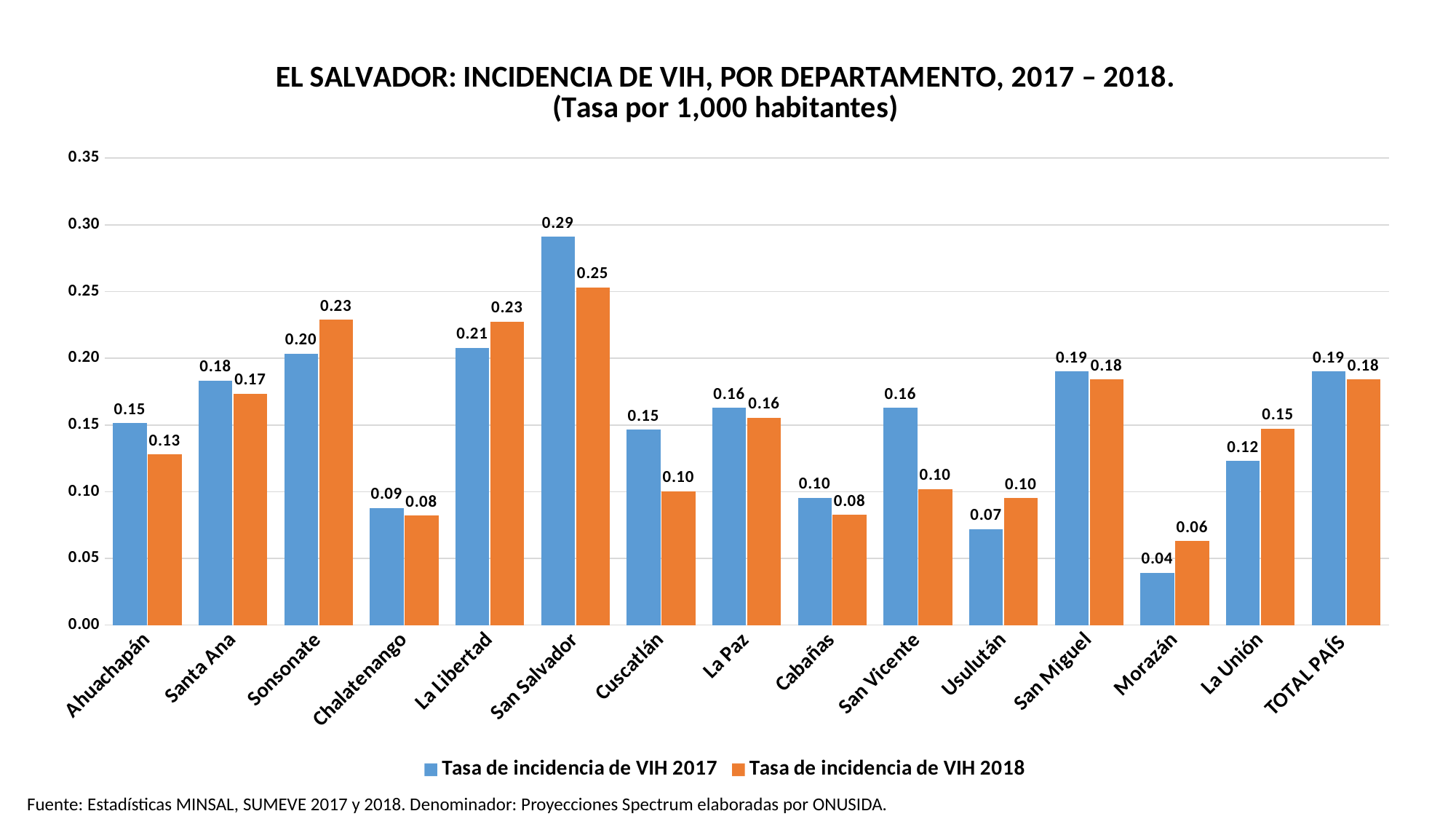
Which department has the lowest 2018 HIV incidence rate? Morazán What kind of chart is shown on the slide? Bar chart Which is larger for Sonsonate: the 2017 rate or the 2018 rate? 2018 rate What is the 2018 HIV incidence rate for TOTAL PAÍS? 0.18 Which department has the highest 2017 HIV incidence rate? San Salvador What is the difference between the 2017 and 2018 HIV incidence rates for San Salvador? 0.04 How many series does the legend list? 2 How many categories are shown on the x axis? 15 What is the 2017 HIV incidence rate for San Salvador? 0.29 Is the 2017 HIV incidence rate for Morazán greater or less than 0.05? less What is the 2018 HIV incidence rate for La Unión? 0.15 What colour represents the 2018 HIV incidence rate series? Orange